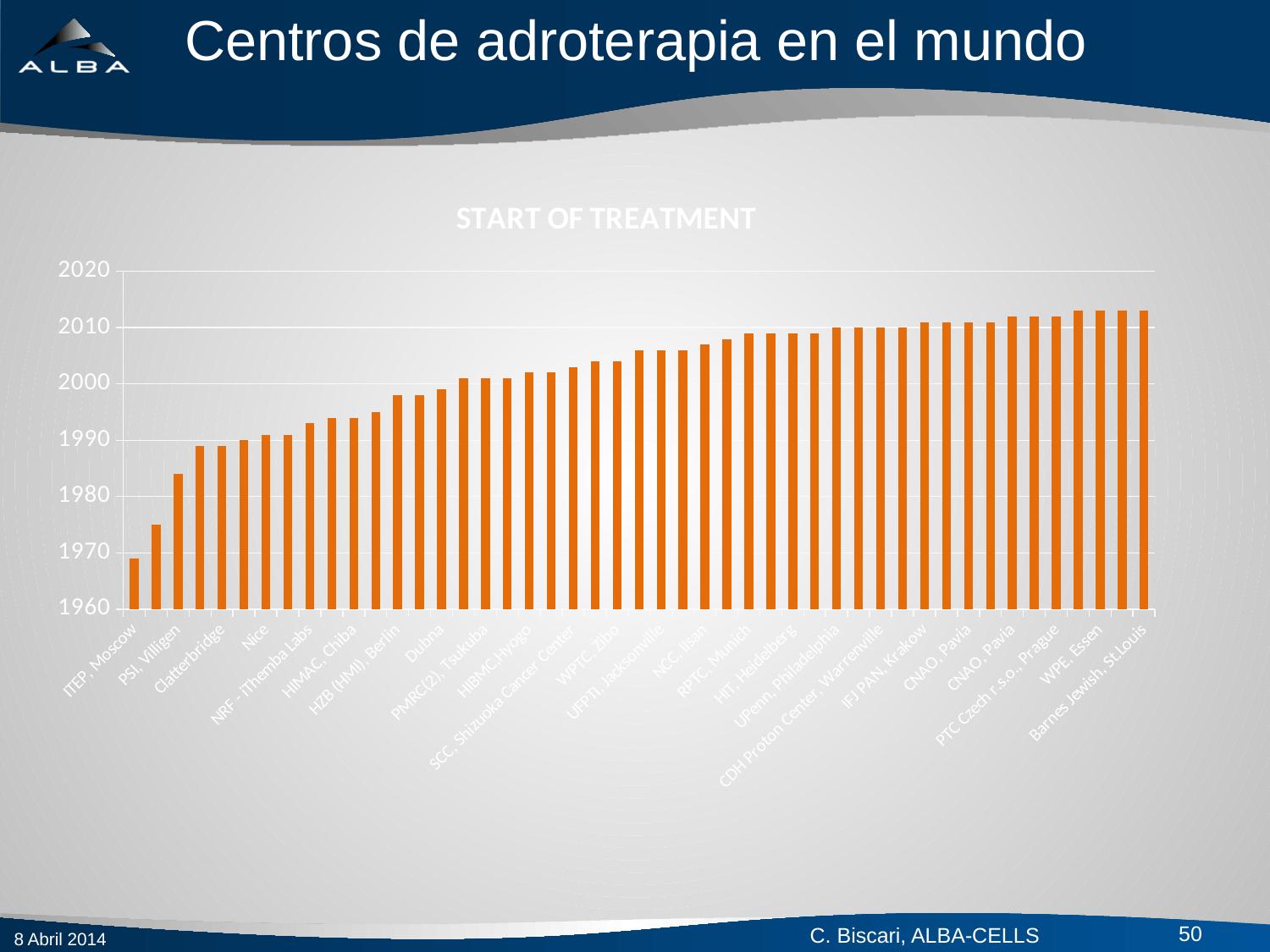
Is the value for WPTC, Zibo greater or less than 2000? greater Is the value for HIT, Heidelberg greater or less than 2000? greater Which is larger, the value for ITEP, Moscow or the value for WPE, Essen? WPE, Essen Is the value for WPE, Essen greater or less than 2010? greater Which is larger, the value for PSI, Villigen or the value for HIMAC, Chiba? HIMAC, Chiba Do the values generally rise or fall from left to right along the x axis? rise Which category has the lowest value in the chart? ITEP, Moscow What is the title of the chart? START OF TREATMENT What kind of chart is shown on the slide? bar chart